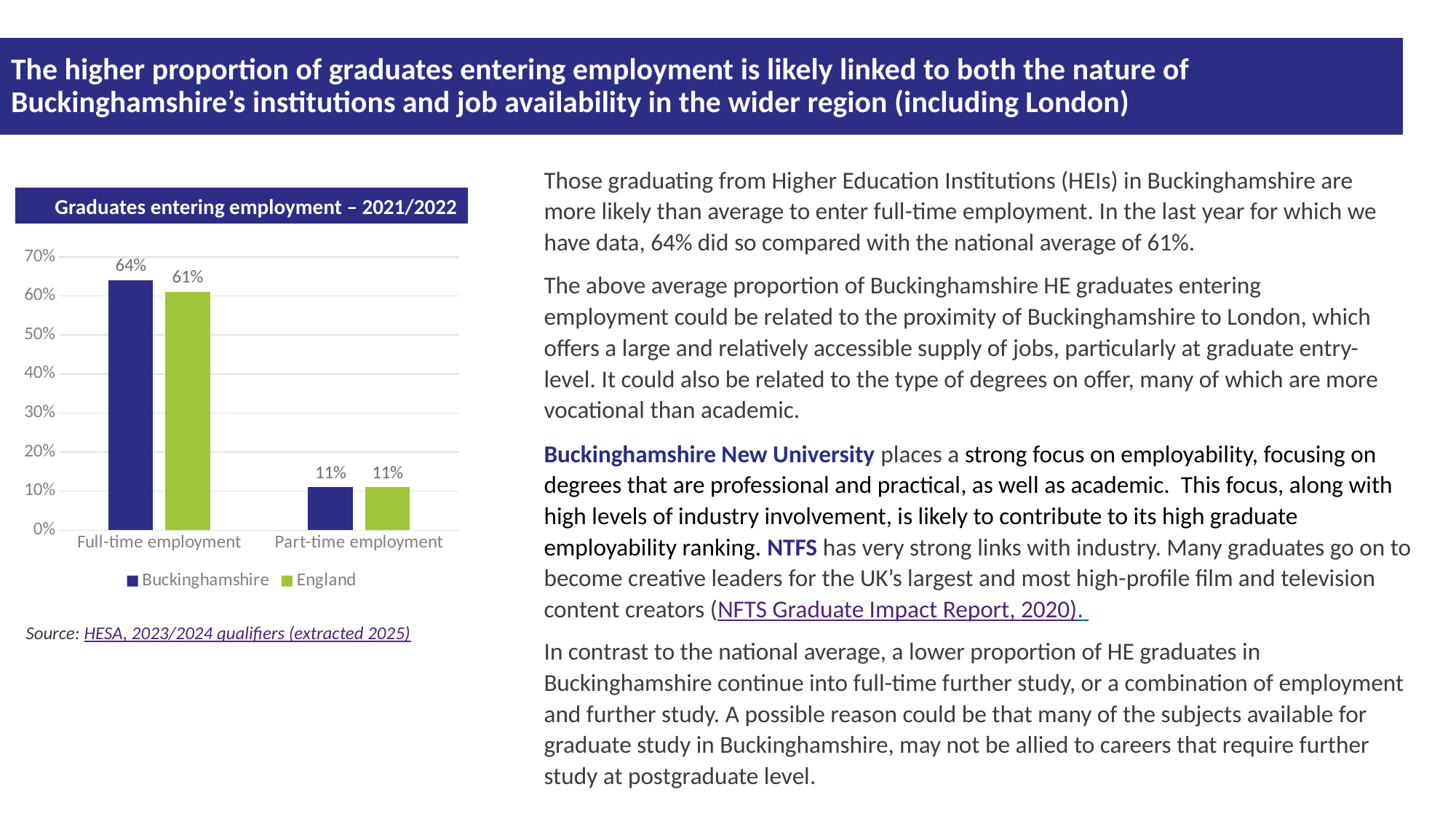
How many categories are shown on the x axis? 2 What is the value for England in Full-time employment? 61% Which series has the higher value for Full-time employment, Buckinghamshire or England? Buckinghamshire What is the difference between the Buckinghamshire values for Full-time employment and Part-time employment? 53% What is the value for Buckinghamshire in Part-time employment? 11% What is the title of the chart? Graduates entering employment – 2021/2022 What is the value for Buckinghamshire in Full-time employment? 64% What kind of chart is shown on the slide? Bar chart What is the value for England in Part-time employment? 11% How many series does the legend list? 2 Which category has the highest value for England? Full-time employment What is the difference between the Buckinghamshire and England values for Full-time employment? 3%